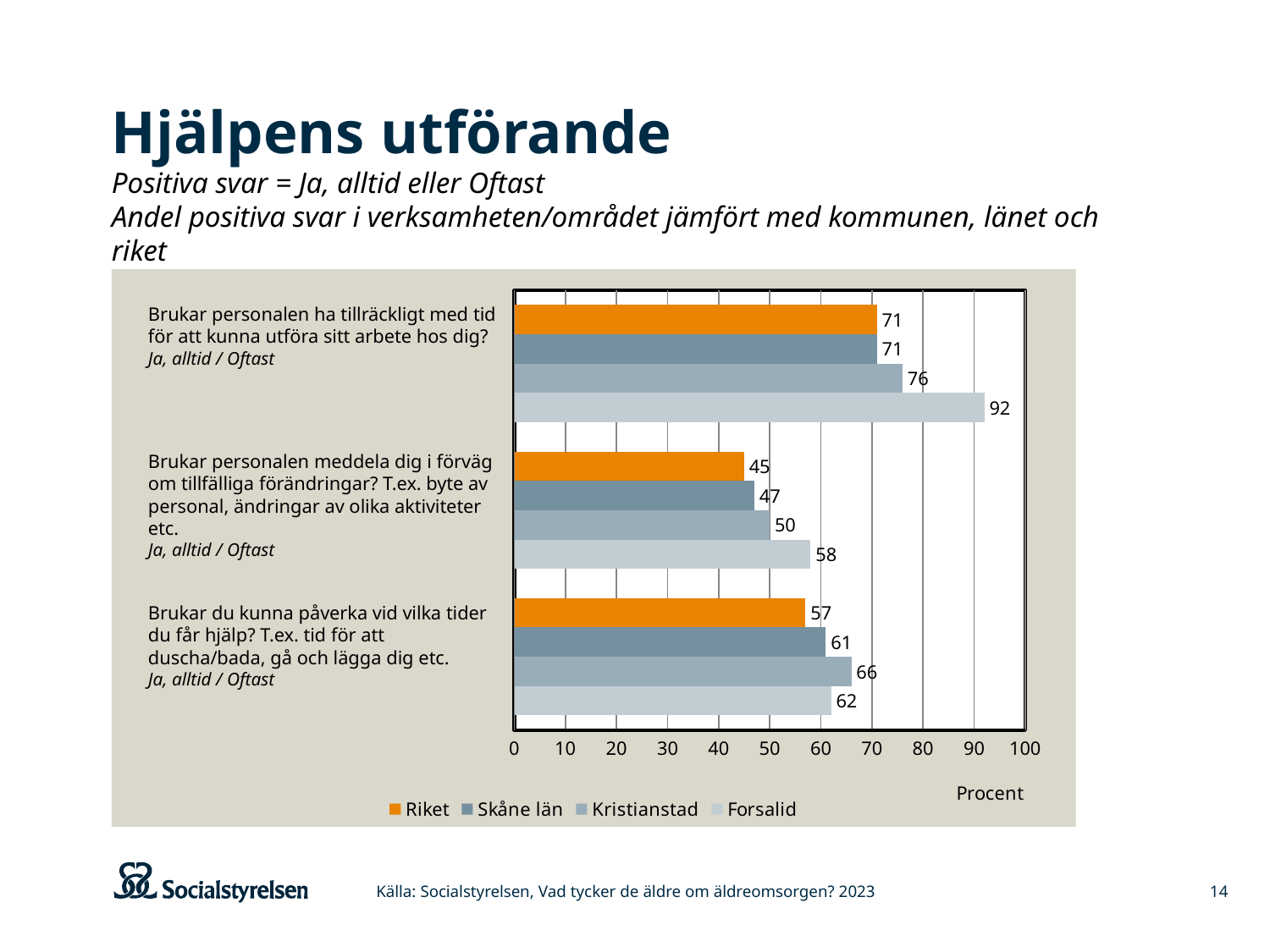
Which series has the highest value on the question "Brukar personalen ha tillräckligt med tid för att kunna utföra sitt arbete hos dig?"? Forsalid On the question "Brukar du kunna påverka vid vilka tider du får hjälp?", which is larger: Kristianstad or Forsalid? Kristianstad What kind of chart is shown on the slide? Bar chart What unit label is shown below the x axis of the chart? Procent What is the value for Forsalid on the question "Brukar personalen ha tillräckligt med tid för att kunna utföra sitt arbete hos dig?"? 92 How many question categories are shown in the chart? 3 What is the difference between Forsalid and Riket on the question "Brukar personalen ha tillräckligt med tid för att kunna utföra sitt arbete hos dig?"? 21 What is the value for Kristianstad on the question "Brukar du kunna påverka vid vilka tider du får hjälp?"? 66 How many series does the legend list? 4 What is the value for Riket on the question "Brukar personalen meddela dig i förväg om tillfälliga förändringar?"? 45 Is the value for Forsalid on the question "Brukar personalen meddela dig i förväg om tillfälliga förändringar?" greater or less than 50? greater Which series has the lowest value on the question "Brukar personalen meddela dig i förväg om tillfälliga förändringar?"? Riket